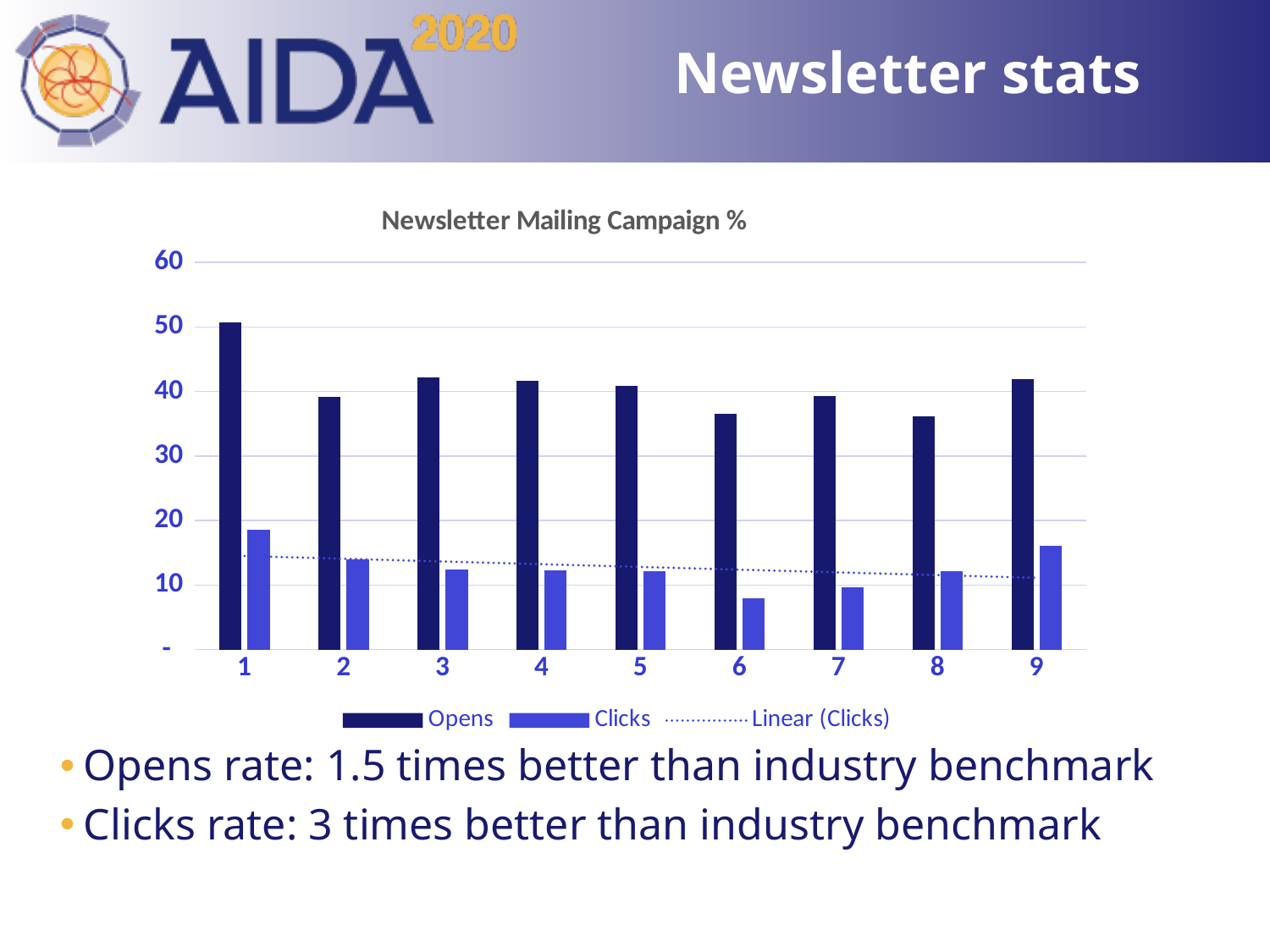
What kind of chart is shown on the slide? bar chart Does the Linear (Clicks) trendline rise or fall from category 1 to category 9? fall Is the Opens value for category 1 greater or less than 40? greater How many categories are shown on the x axis of the chart? 9 How many entries does the chart legend list? 3 Is the Opens value for category 6 greater or less than 40? less Which is larger, the Clicks value for category 1 or the Clicks value for category 9? category 1 Is the Clicks value for category 6 greater or less than 10? less Which category has the highest Opens value? 1 Which category has the highest Clicks value? 1 What is the title of the chart? Newsletter Mailing Campaign % Which category has the lowest Clicks value? 6